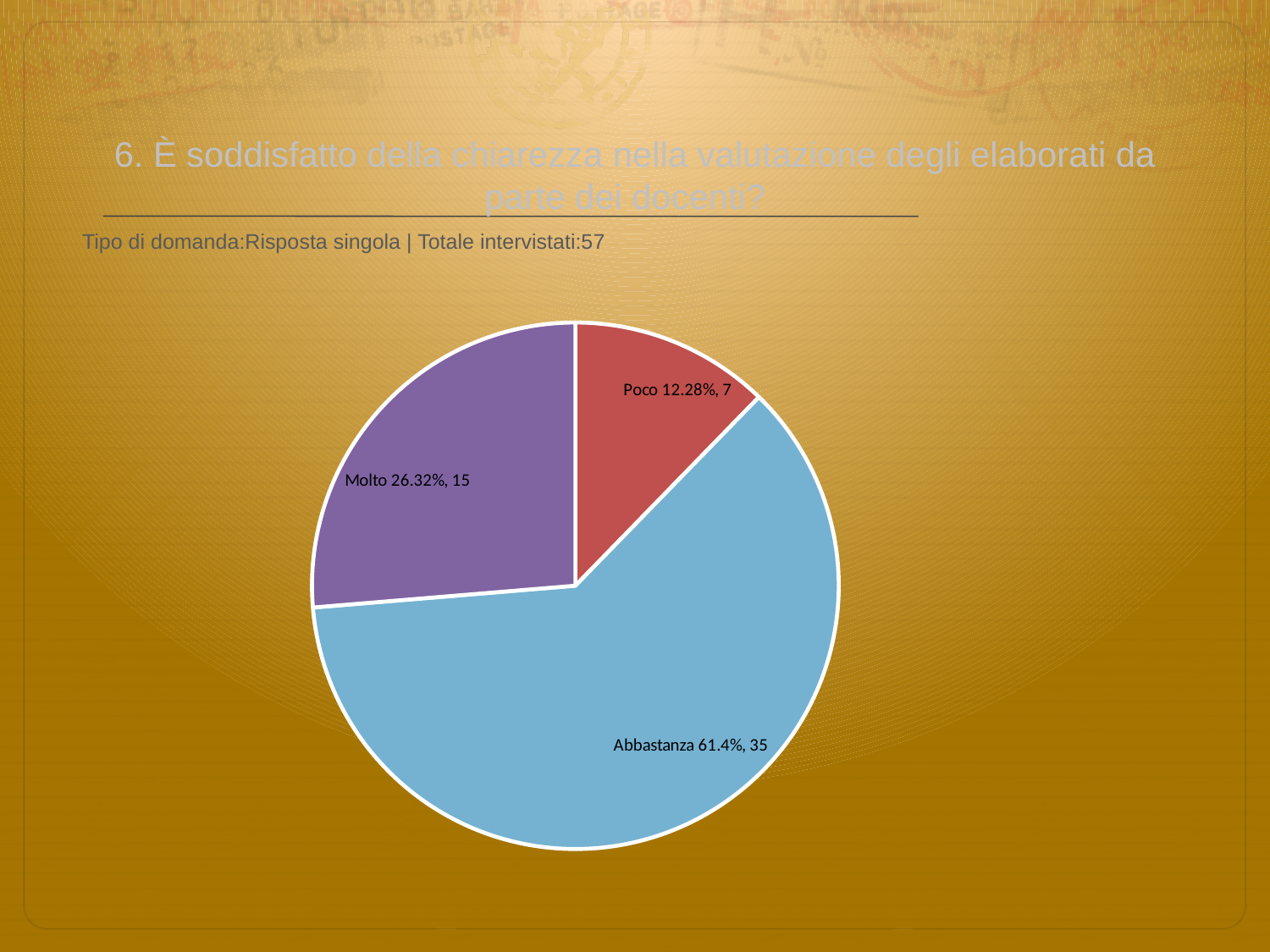
What percentage share does the Abbastanza slice have? 61.4% Which category has the smallest slice? Poco How many respondents answered Poco? 7 How many respondents answered Abbastanza? 35 How many respondents answered Molto? 15 Which category has the largest slice? Abbastanza What is the difference in respondent count between Abbastanza and Molto? 20 What percentage share does the Poco slice have? 12.28% How many slices does the pie chart have? 3 What kind of chart is shown on the slide? pie chart What percentage share does the Molto slice have? 26.32% Which slice is larger, Molto or Poco? Molto